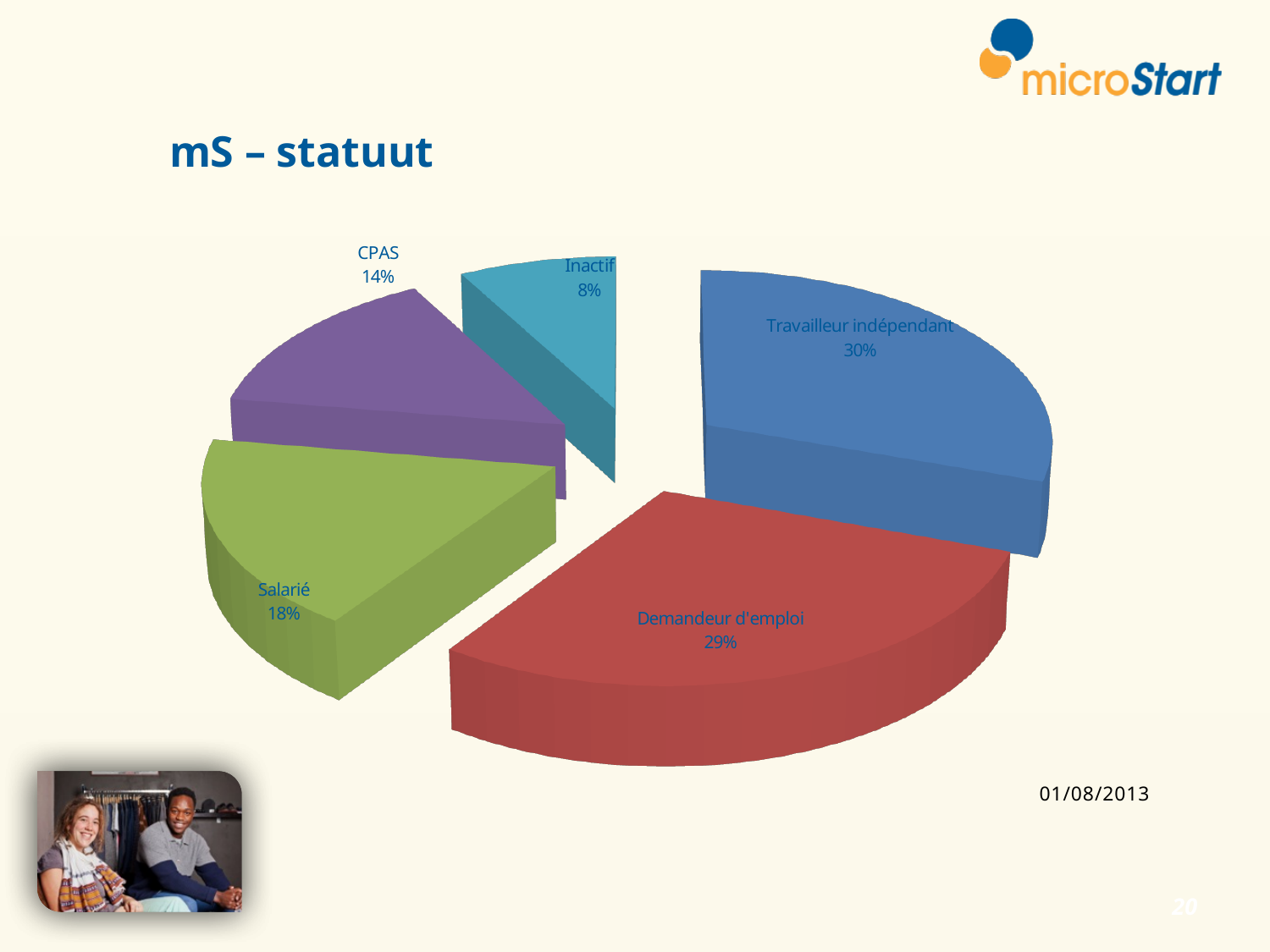
What share of the pie does Salarié have? 18% What share of the pie does CPAS have? 14% Which category has the smallest share of the pie? Inactif What share of the pie does Demandeur d'emploi have? 29% Which is larger, the share for Salarié or the share for Inactif? Salarié What is the difference in percentage points between Salarié and CPAS? 4 Which category has the largest share of the pie? Travailleur indépendant What is the title of the slide containing the chart? mS – statuut What kind of chart is shown on the slide? pie chart How many categories does the pie chart show? 5